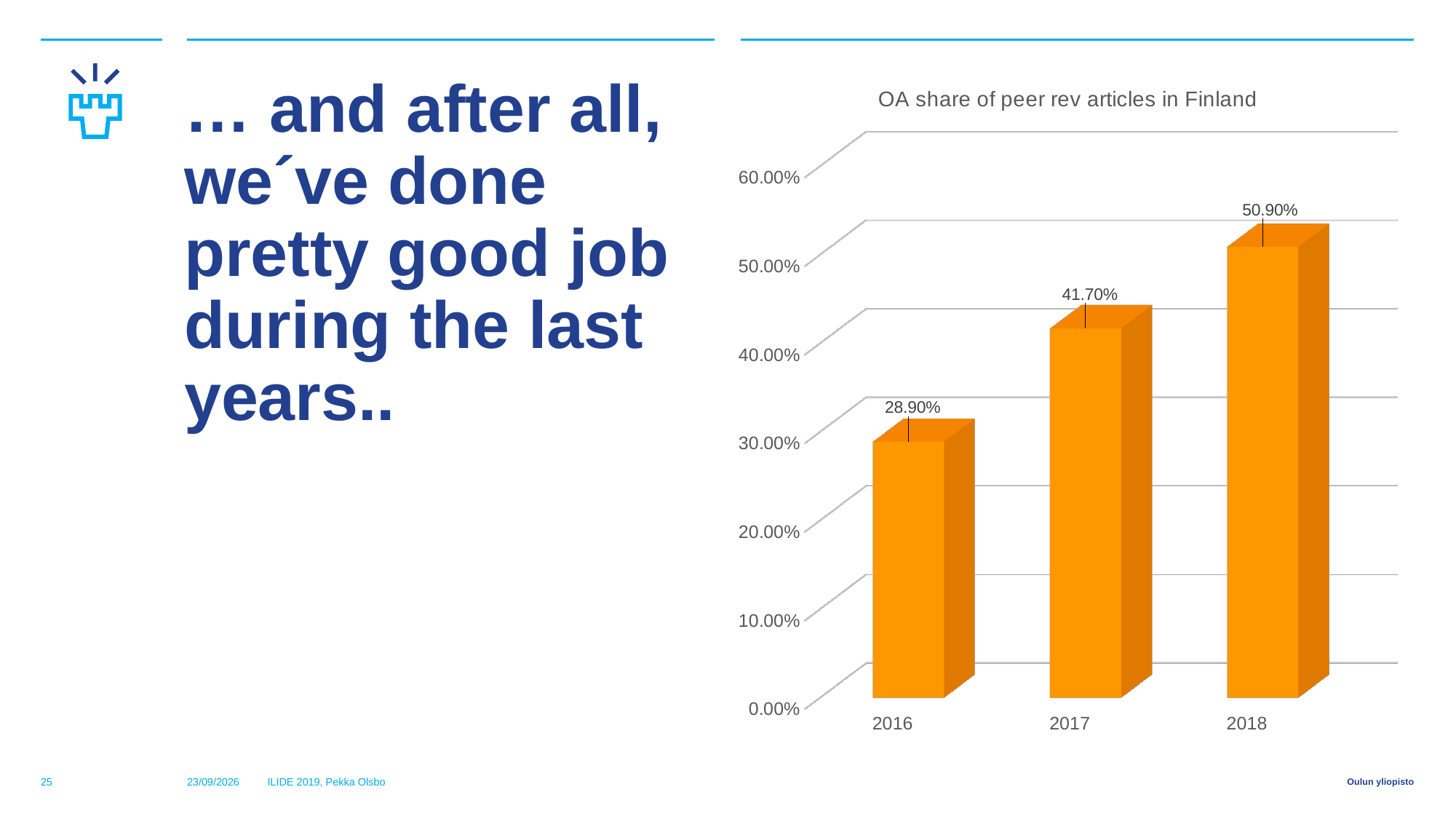
By how many percentage points did the OA share increase from 2016 to 2018? 22 percentage points What is the OA share of peer reviewed articles in Finland for 2018? 50.90% Is the OA share for 2018 greater or less than 50.00%? greater By how many percentage points did the OA share increase from 2017 to 2018? 9.2 percentage points What is the OA share of peer reviewed articles in Finland for 2016? 28.90% Which year has the lowest OA share? 2016 Does the OA share rise or fall from 2016 to 2018? Rise Which year has a larger OA share, 2016 or 2017? 2017 Which year has the highest OA share? 2018 What kind of chart is used to show the OA share? Bar chart What is the OA share of peer reviewed articles in Finland for 2017? 41.70% How many years are shown on the chart? 3